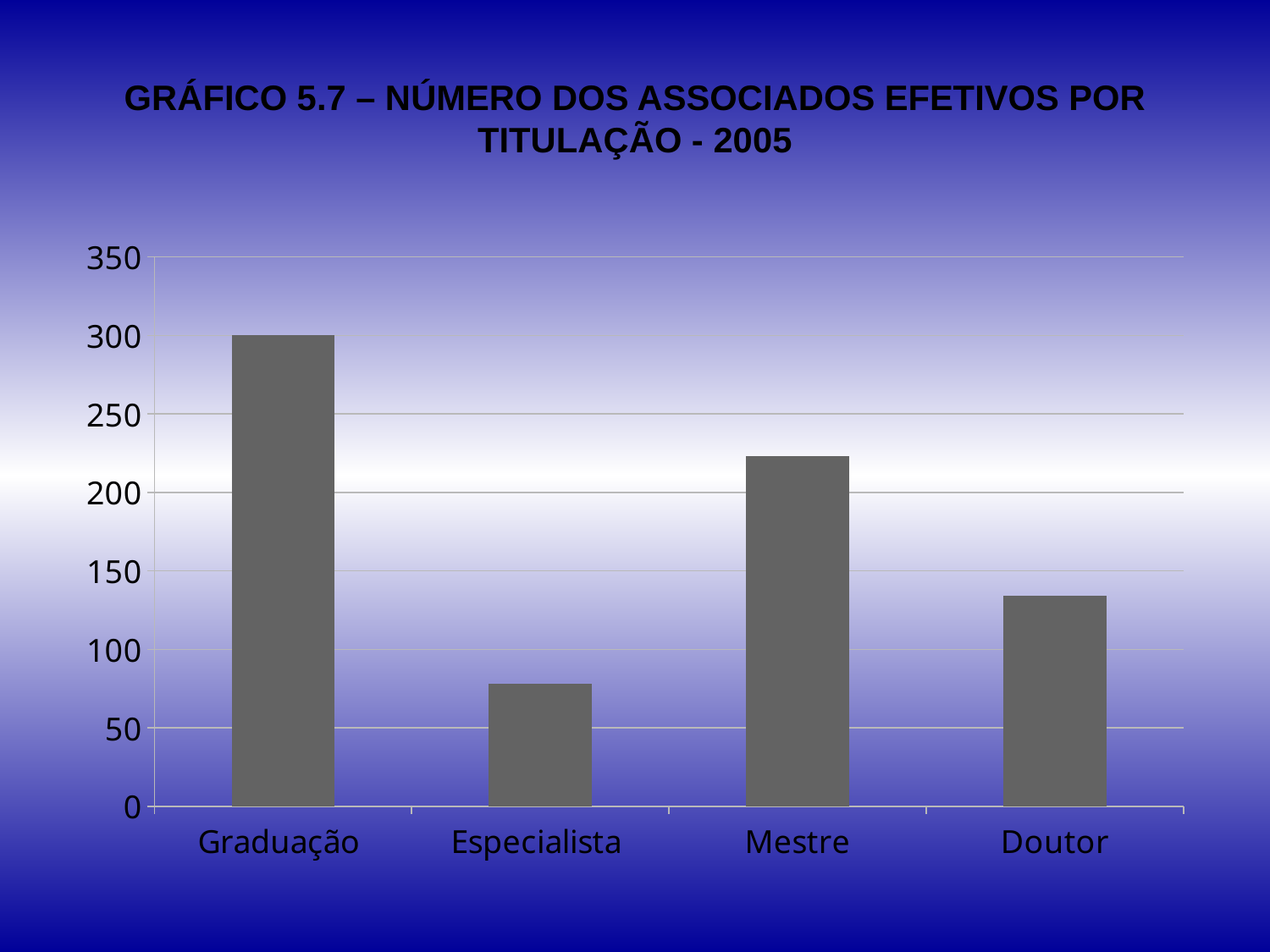
What year does the chart title refer to? 2005 How many categories are shown on the x axis of the chart? 4 Which category has the highest number of associados efetivos? Graduação Which is larger, the value for Especialista or the value for Doutor? Doutor Is the value for Mestre greater or less than 200? greater Is the value for Mestre greater or less than 250? less Is the value for Especialista greater or less than 100? less What is the value for Graduação? 300 Which is larger, the value for Mestre or the value for Doutor? Mestre Which category has the lowest number of associados efetivos? Especialista What kind of chart is shown on the slide? bar chart